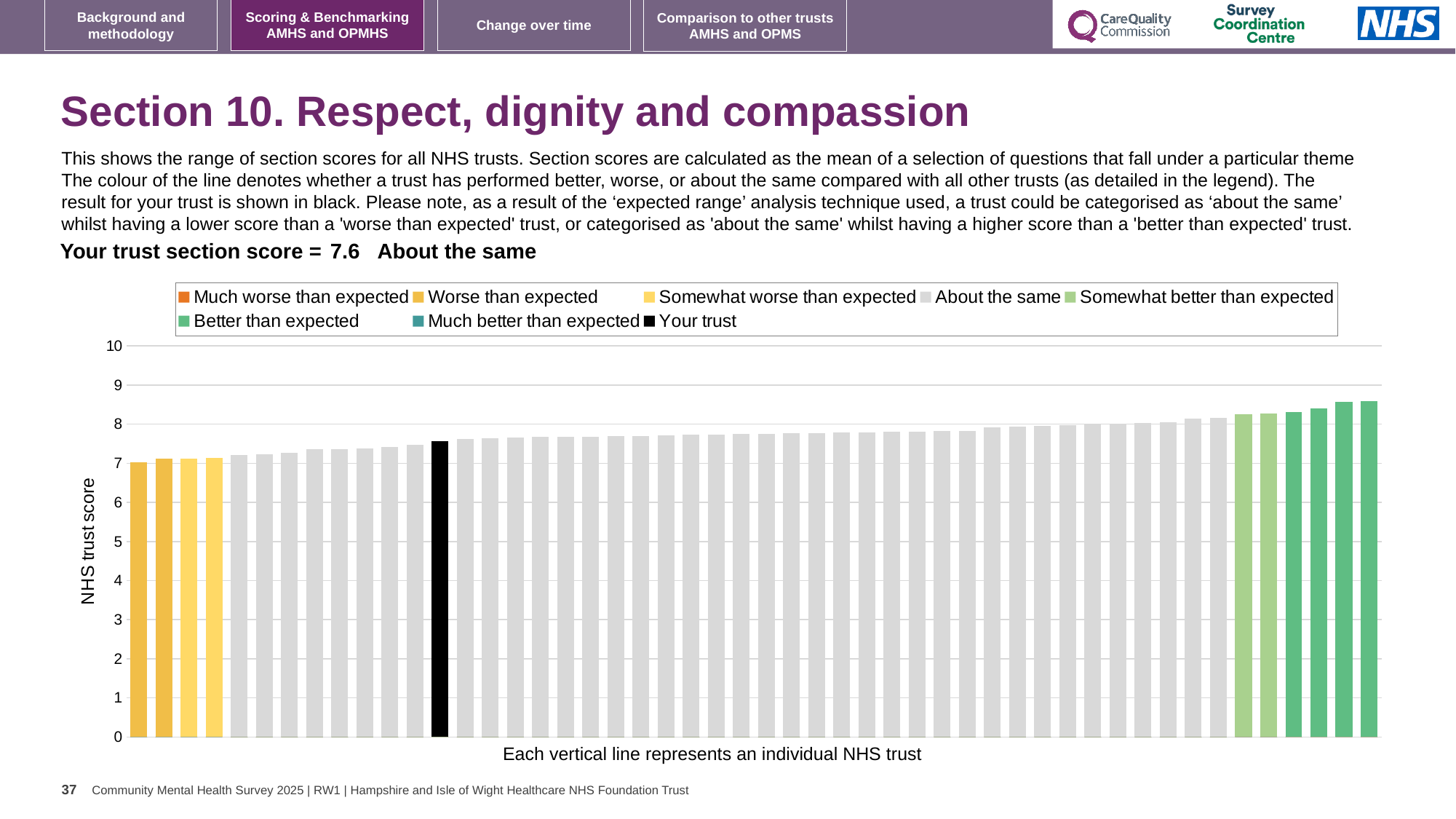
How many bars are coloured as 'Worse than expected' (yellow) in the chart? 2 What colour is the bar representing your trust? black Is the value of the leftmost (lowest) bar greater or less than 8? less How many bars are coloured as 'Better than expected' (dark green) in the chart? 4 Is the value of the rightmost (highest) bar greater or less than 8? greater Is the value for your trust greater or less than 8? less What is the section score for your trust shown on the slide? 7.6 Do the bar values rise or fall from left to right along the x axis? rise What kind of chart is shown on the slide? bar chart How many entries does the chart legend list? 8 What is the label on the vertical axis of the chart? NHS trust score